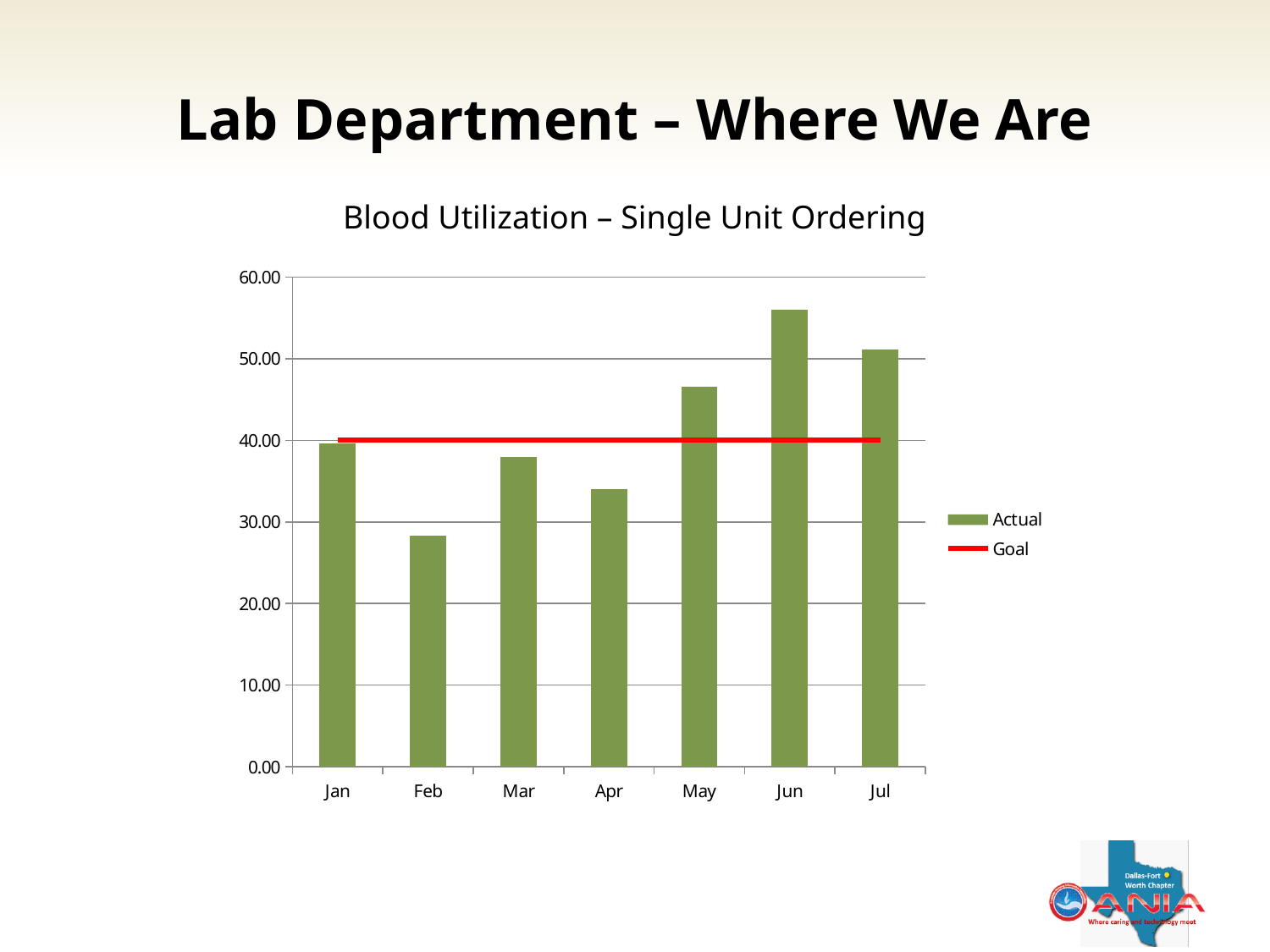
What kind of chart is shown on the slide? Combination bar and line chart Which month has the lowest Actual value? Feb Do the Actual values rise or fall from Apr to Jun? Rise Is the Actual value for Feb greater or less than 30.00? less Is the Actual value for Apr greater or less than 40.00? less How many months are shown on the x axis of the chart? 7 Is the Actual value for Jun greater or less than 50.00? greater Which month has a larger Actual value, May or Apr? May What is the title of the chart? Blood Utilization – Single Unit Ordering What value does the Goal line sit at? 40.00 Which month has the highest Actual value? Jun How many series does the chart legend list? 2